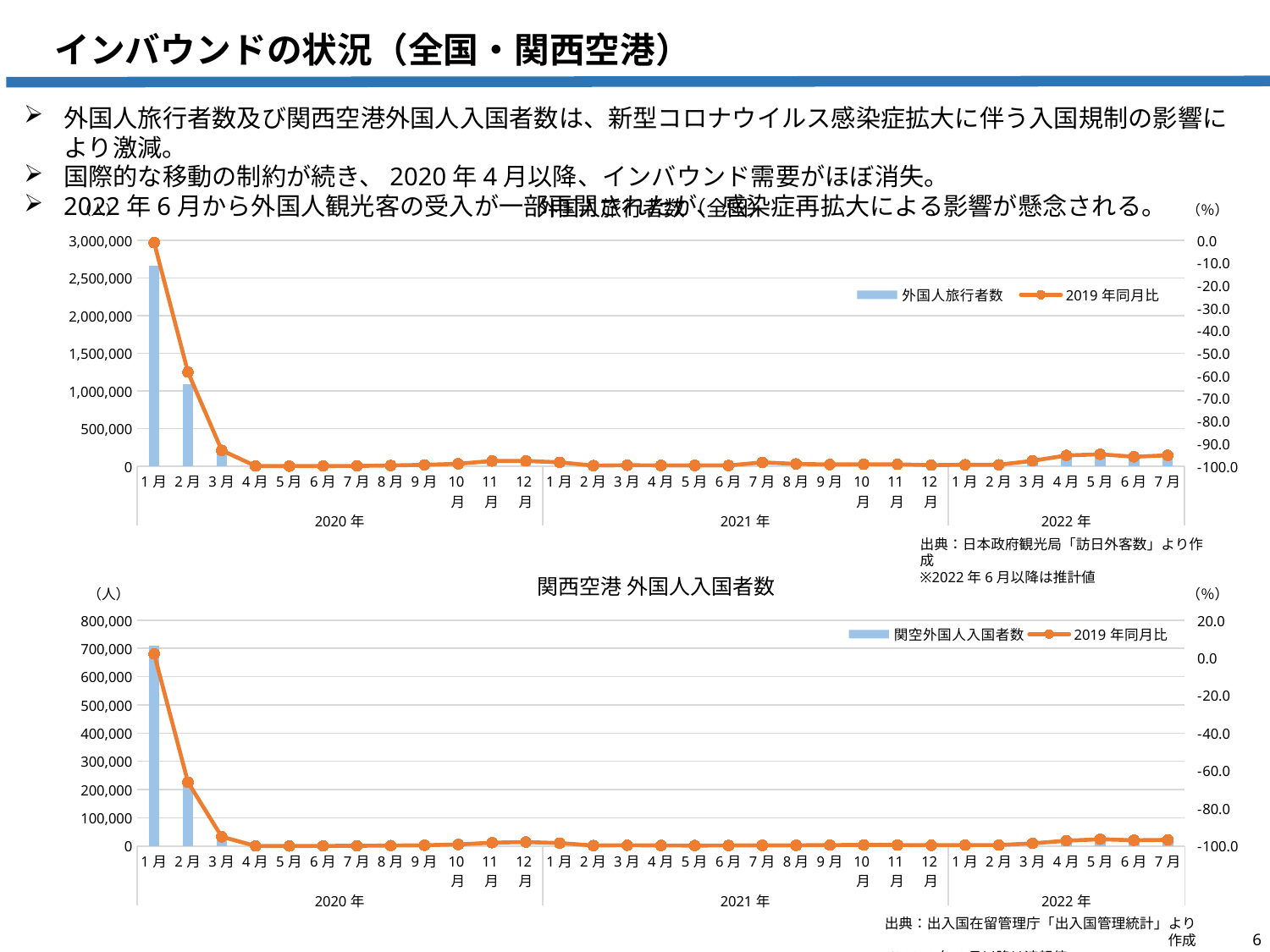
In the bottom chart (関西空港 外国人入国者数), which month has the highest 関空外国人入国者数 bar? 2020年1月 In the bottom chart (関西空港 外国人入国者数), do the 関空外国人入国者数 values rise or fall from 2020年1月 to 2020年4月? fall In the top chart, which is larger, the 外国人旅行者数 bar for 2020年1月 or for 2020年2月? 2020年1月 What are the two legend entries of the top chart? 外国人旅行者数, 2019年同月比 In the bottom chart (関西空港 外国人入国者数), is the 関空外国人入国者数 value for 2020年3月 greater or less than 100,000? less In the top chart, is the 外国人旅行者数 value for 2020年3月 greater or less than 500,000? less In the bottom chart (関西空港 外国人入国者数), is the 関空外国人入国者数 value for 2020年1月 greater or less than 600,000? greater In the top chart, which month has the highest 外国人旅行者数 bar? 2020年1月 How many months are shown along the x axis of the bottom chart (関西空港 外国人入国者数)? 31 How many series does the legend of the bottom chart (関西空港 外国人入国者数) list? 2 What kind of chart is the bottom chart titled 関西空港 外国人入国者数? Combined bar and line chart